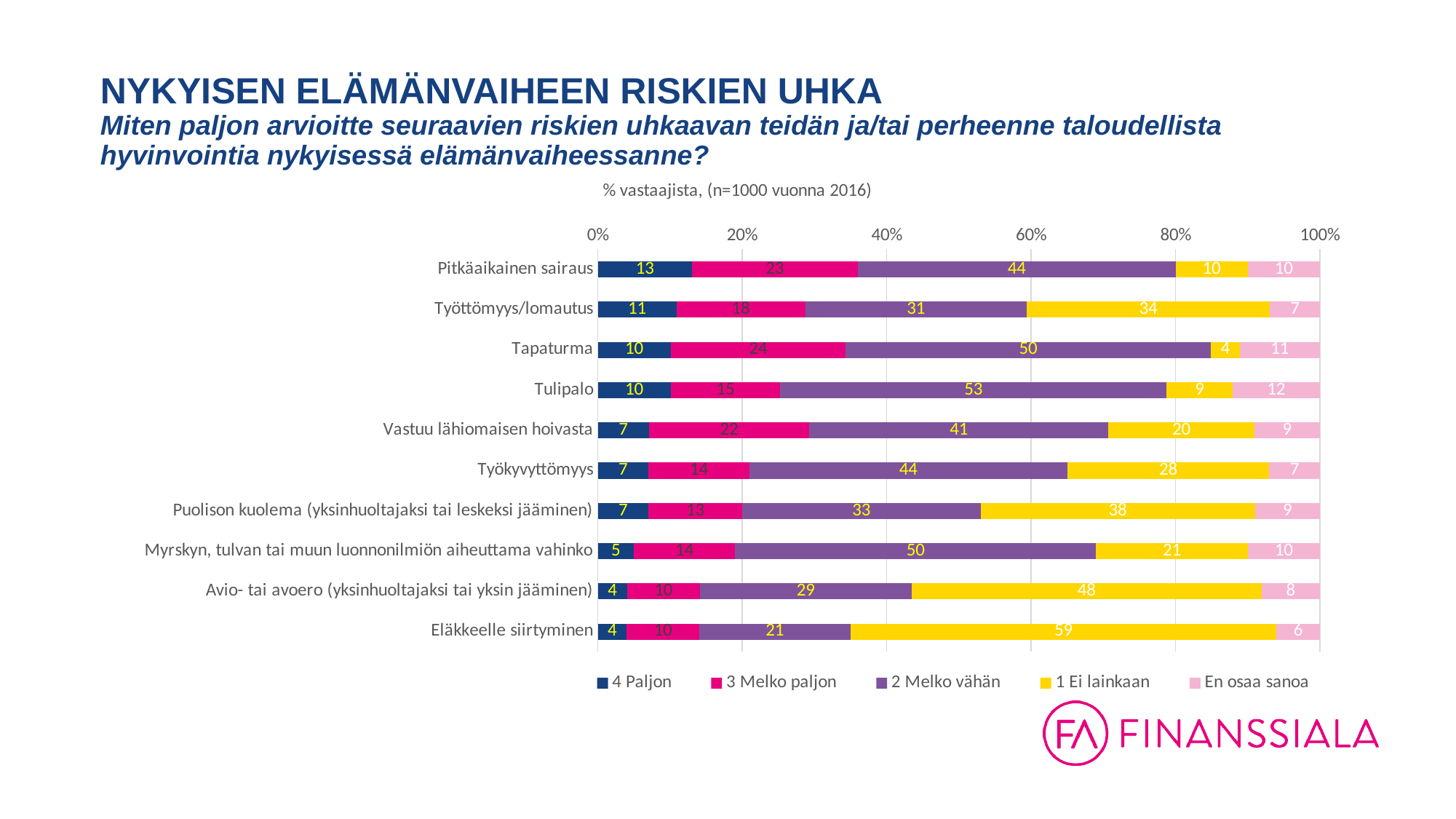
What is the difference between the "3 Melko paljon" values for Tapaturma and Tulipalo? 9 What kind of chart is shown on the slide? Stacked bar chart What is the value of "4 Paljon" for Pitkäaikainen sairaus? 13 How many series does the legend list? 5 Which category has the highest value for "4 Paljon"? Pitkäaikainen sairaus What is the total of the stacked bar for Työkyvyttömyys? 100 Which category has the lowest value for "1 Ei lainkaan"? Tapaturma What is the value of "2 Melko vähän" for Tulipalo? 53 How many categories are shown in the chart? 10 What is the value of "1 Ei lainkaan" for Eläkkeelle siirtyminen? 59 Which is larger: the "1 Ei lainkaan" value for Avio- tai avoero or for Puolison kuolema? Avio- tai avoero What is the value of "En osaa sanoa" for Työttömyys/lomautus? 7